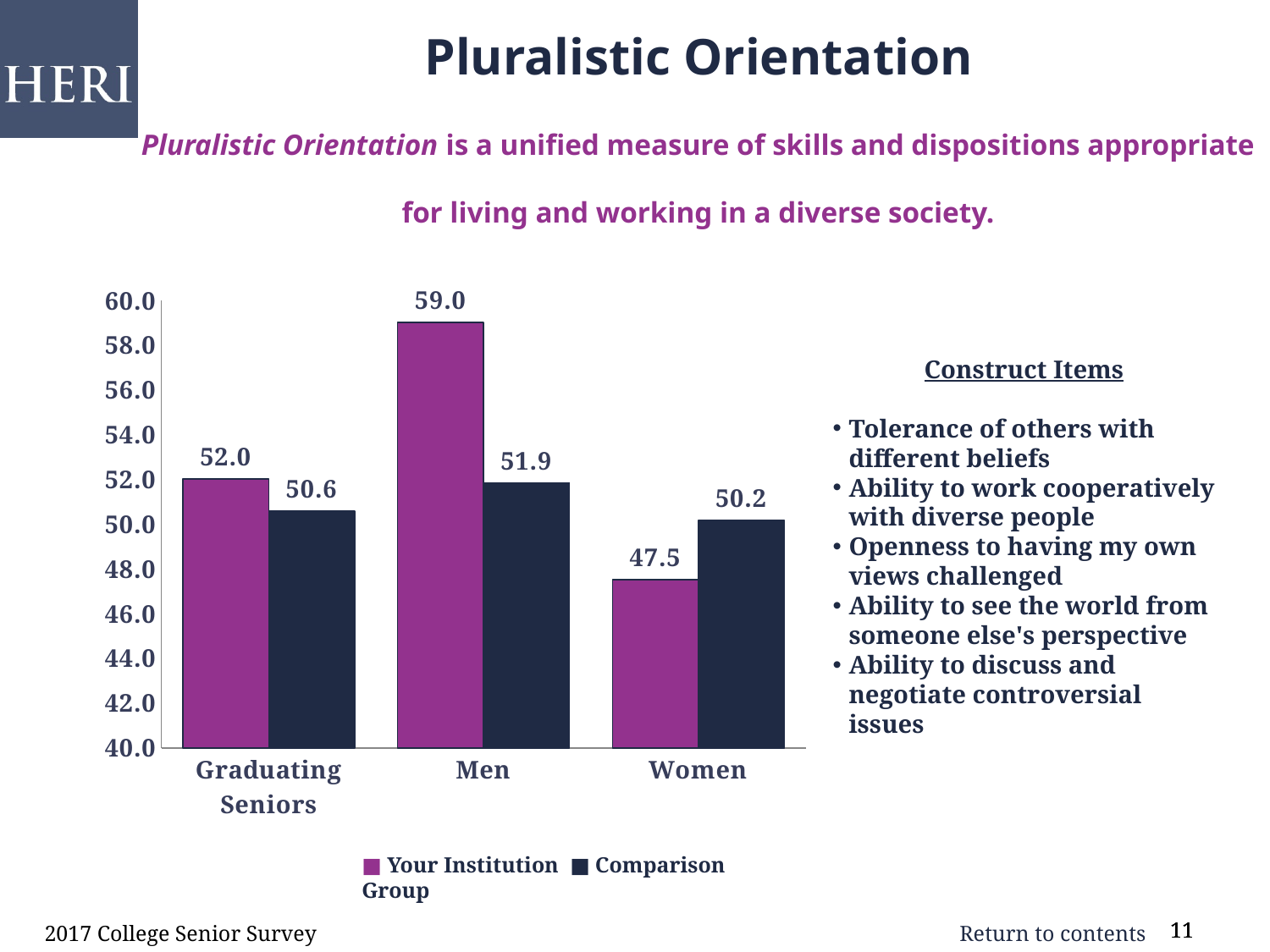
What kind of chart is shown on the slide? bar chart What is the Comparison Group value for Women? 50.2 What is the Your Institution value for Men? 59.0 Which colour represents the Comparison Group series? dark navy What is the Your Institution value for Graduating Seniors? 52.0 For Women, which is larger: the Your Institution value or the Comparison Group value? Comparison Group What is the difference between the Your Institution and Comparison Group values for Men? 7.1 Is the Your Institution value for Women greater or less than 48.0? less Which category has the highest Your Institution value? Men How many categories are shown on the x axis? 3 How many series does the legend list? 2 Which category has the lowest Your Institution value? Women